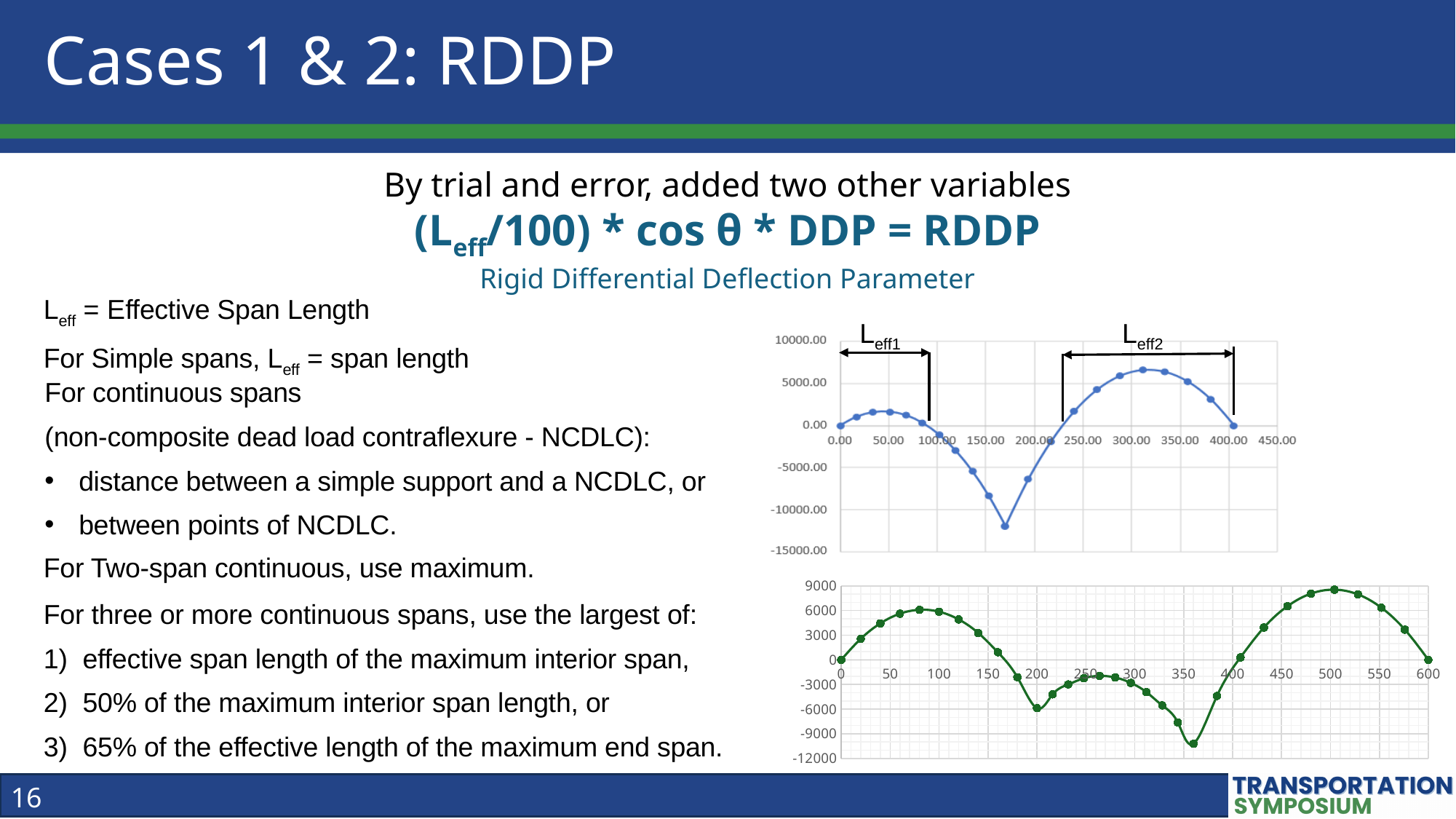
In the bottom chart, is the value at x = 500 greater or less than 6000? greater In the top chart, which peak is higher: the one near x = 50.00 or the one near x = 300.00? the one near x = 300.00 What colour is the line in the top chart? blue In the bottom chart, is the lowest point of the line greater or less than -9000? less In the top chart, is the lowest point of the line greater or less than -10000.00? less In the bottom chart, which dip is lower: the one near x = 200 or the one near x = 350? the one near x = 350 What kind of chart is the top chart on the slide? line chart What kind of chart is the bottom chart on the slide? line chart What is the largest tick label on the x axis of the bottom chart? 600